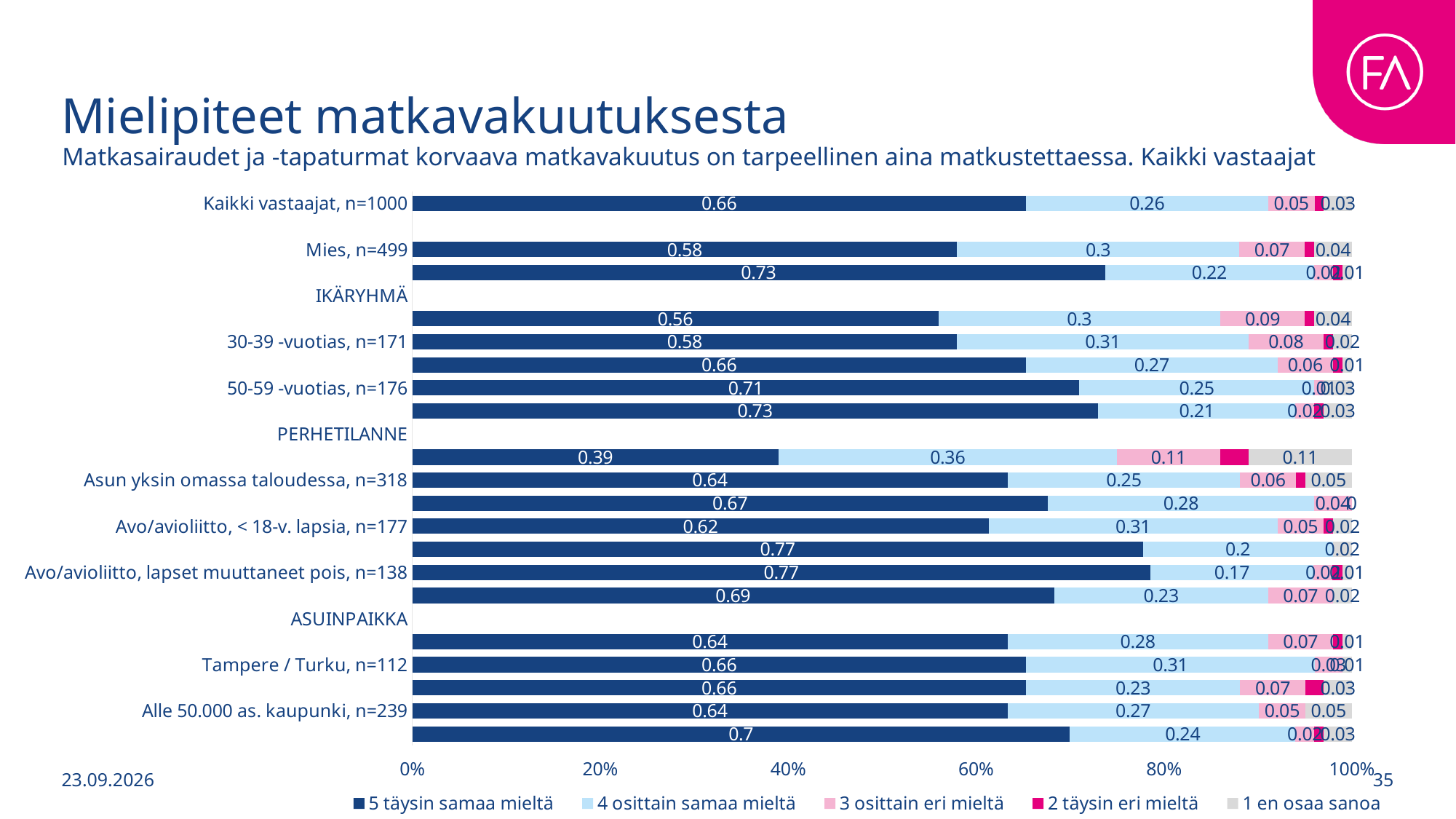
What is the value of "1 en osaa sanoa" for "Asun yksin omassa taloudessa, n=318"? 0.05 What kind of chart is shown on the slide? Stacked bar chart What is the value of "5 täysin samaa mieltä" for "Kaikki vastaajat, n=1000"? 0.66 What is the value of "3 osittain eri mieltä" for "30-39 -vuotias, n=171"? 0.08 What is the title of the slide? Mielipiteet matkavakuutuksesta What is the value of "4 osittain samaa mieltä" for "Alle 50.000 as. kaupunki, n=239"? 0.27 Is the "5 täysin samaa mieltä" value for "Avo/avioliitto, < 18-v. lapsia, n=177" greater or less than 60%? greater How many series does the legend list? 5 What is the value of "5 täysin samaa mieltä" for "Avo/avioliitto, lapset muuttaneet pois, n=138"? 0.77 Which has a larger "5 täysin samaa mieltä" value: "Mies, n=499" or "50-59 -vuotias, n=176"? 50-59 -vuotias, n=176 What is the value of "4 osittain samaa mieltä" for "Mies, n=499"? 0.3 What is the difference between the "5 täysin samaa mieltä" values for "Kaikki vastaajat, n=1000" and "Mies, n=499"? 0.08